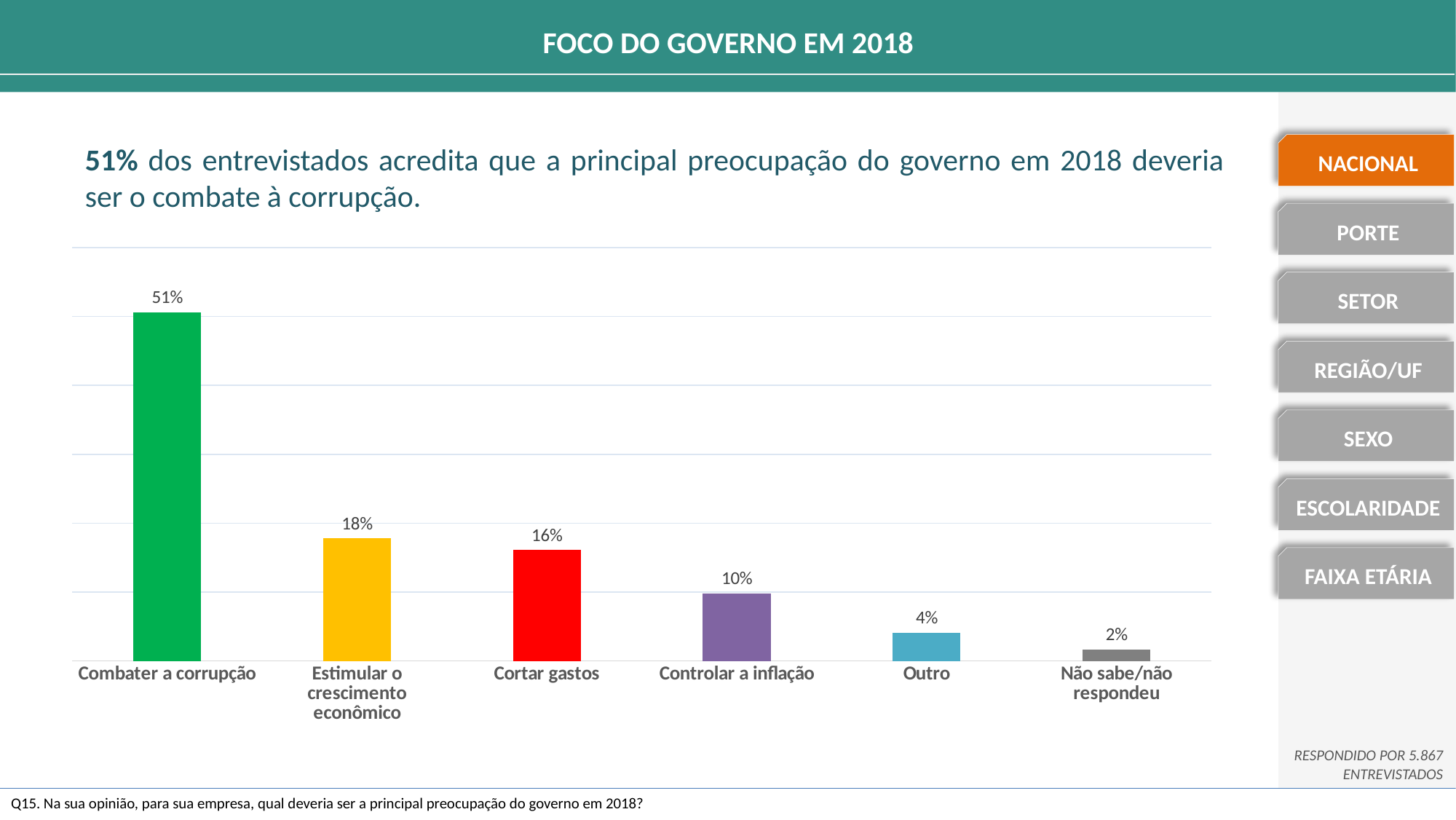
What is the difference between Combater a corrupção and Estimular o crescimento econômico? 33% Which is larger, Controlar a inflação or Outro? Controlar a inflação What is the value for Não sabe/não respondeu? 2% What is the value for Combater a corrupção? 51% What kind of chart is shown on the slide? Bar chart How many categories are shown in the chart? 6 What is the value for Controlar a inflação? 10% What is the value for Cortar gastos? 16% Which category has the highest value? Combater a corrupção What colour is the bar for Cortar gastos? Red What is the value for Estimular o crescimento econômico? 18% Which category has the lowest value? Não sabe/não respondeu